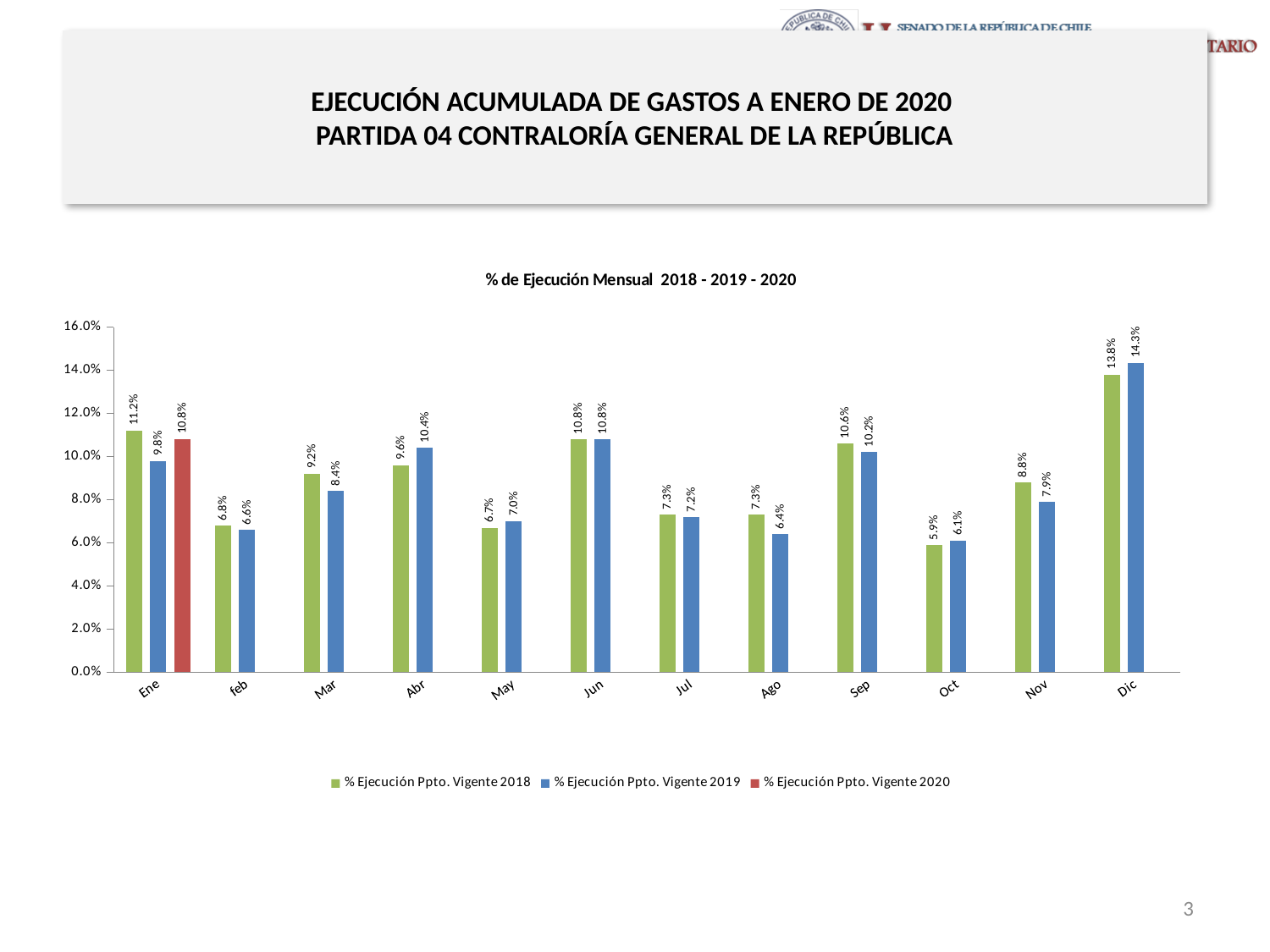
Which month has the lowest value for % Ejecución Ppto. Vigente 2018? Oct What kind of chart is shown on the slide? Bar chart What is the difference between the 2018 and 2019 values in Ene? 1.4% How many months are shown on the x axis? 12 Is the value for % Ejecución Ppto. Vigente 2019 in Dic greater or less than 14.0%? greater Which month has the highest value for % Ejecución Ppto. Vigente 2019? Dic Which is larger in Nov: the 2018 value or the 2019 value? 2018 (8.8%) What is the value for % Ejecución Ppto. Vigente 2018 in Dic? 13.8% What is the title of the chart? % de Ejecución Mensual 2018 - 2019 - 2020 How many series does the legend list? 3 What is the value for % Ejecución Ppto. Vigente 2020 in Ene? 10.8% What is the value for % Ejecución Ppto. Vigente 2019 in Abr? 10.4%